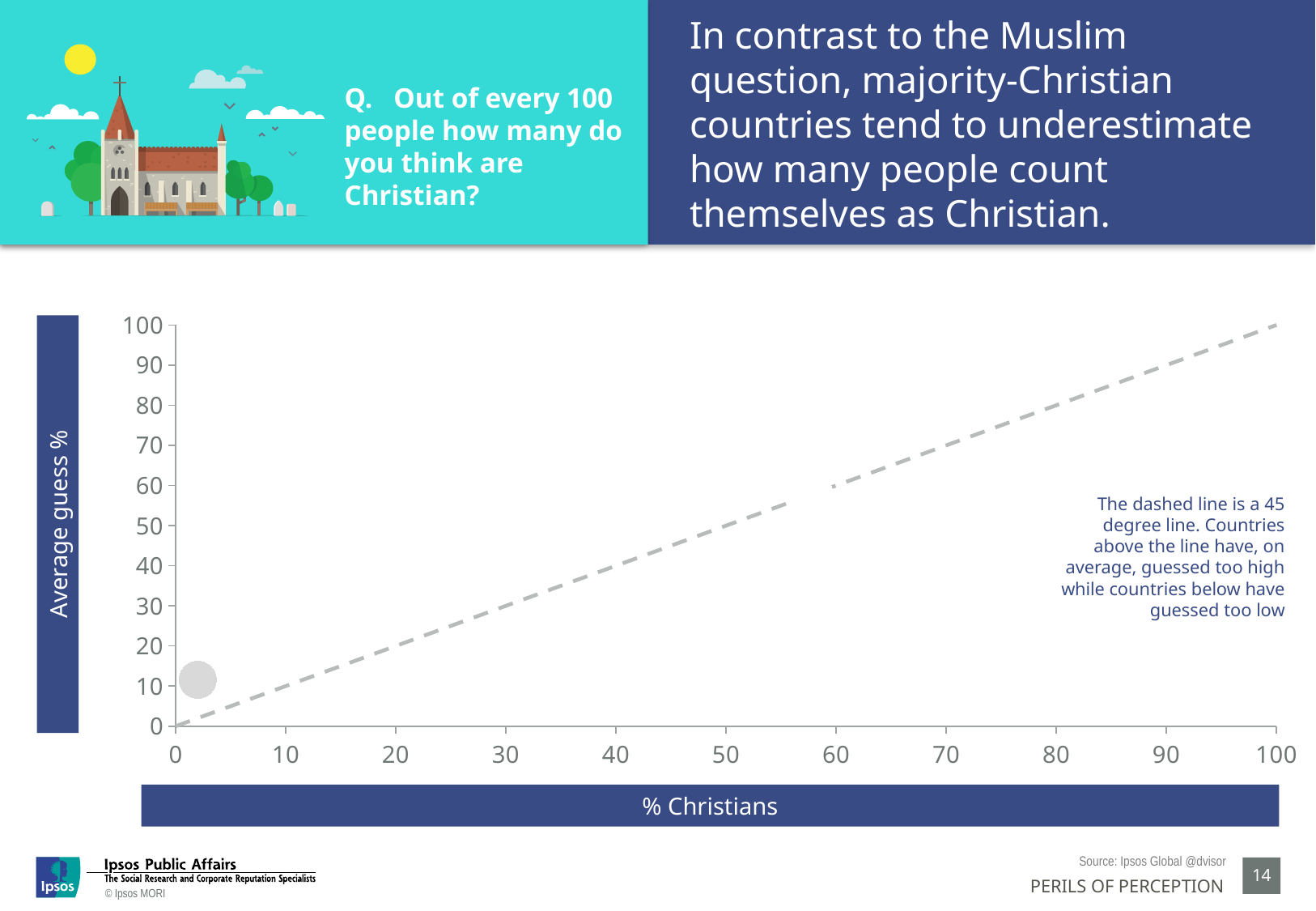
What is the highest value shown on the vertical axis of the chart? 100 Is the average guess value of the plotted point greater or less than 20? less How many data points are plotted on the chart? 1 What is the title of the horizontal axis of the chart? % Christians What kind of chart is shown on the slide? scatter chart What is the title of the vertical axis of the chart? Average guess % Is the plotted point above or below the dashed 45 degree line? above Is the % Christians value of the plotted point greater or less than 10? less Does the dashed line rise or fall as % Christians increases along the x axis? rise